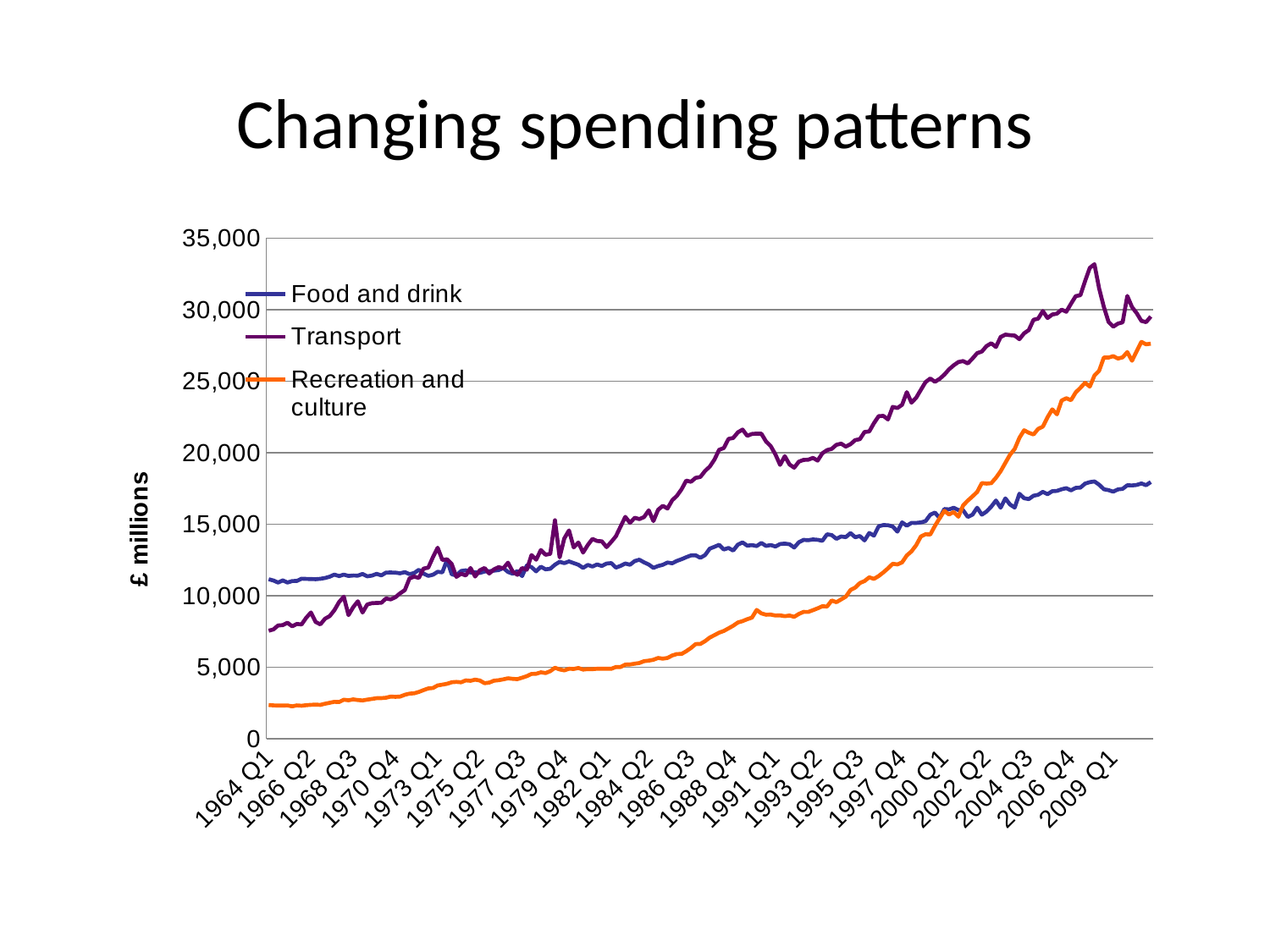
Does the Recreation and culture series generally rise or fall from 1964 Q1 to 2009 Q1? rise Which series reaches the highest value on the chart? Transport Is the peak value for Transport greater or less than 30,000? greater How many series does the legend list? 3 What is the title of the chart? Changing spending patterns Is the value for Food and drink at 2009 Q1 greater or less than 20,000? less Which series has the lowest value at 1964 Q1? Recreation and culture Is the value for Transport at 1964 Q1 greater or less than 10,000? less What kind of chart is shown on the slide? Line chart What is the label on the vertical axis? £ millions At 1964 Q1, which is larger: Food and drink or Transport? Food and drink